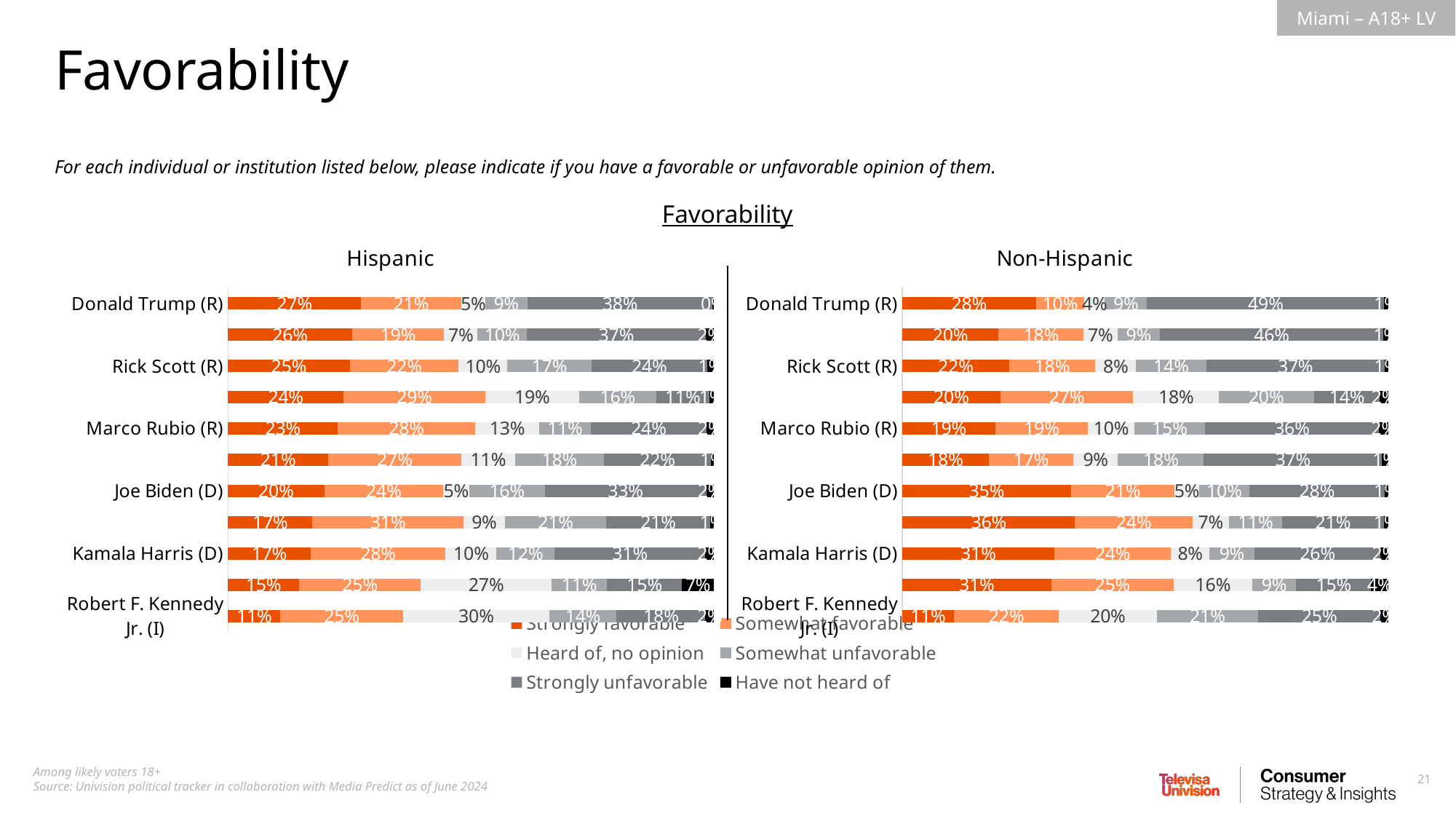
In the Hispanic chart, who has the higher Strongly favorable value, Donald Trump (R) or Joe Biden (D)? Donald Trump (R) In the Hispanic chart, what percentage of respondents are Strongly favorable toward Donald Trump (R)? 27% In the Hispanic chart, what is the 'Heard of, no opinion' value for Robert F. Kennedy Jr. (I)? 30% How many series does the legend list? 6 In the Hispanic chart, what is the Somewhat favorable value for Marco Rubio (R)? 28% In the Non-Hispanic chart, what is the difference between the Strongly unfavorable values for Donald Trump (R) and Joe Biden (D)? 21 percentage points What is the title shown above the two charts? Favorability In the Non-Hispanic chart, what is the Strongly unfavorable value for Rick Scott (R)? 37% In the Hispanic chart, which named individual has the highest Strongly favorable value? Donald Trump (R) In the Non-Hispanic chart, what percentage of respondents are Strongly unfavorable toward Donald Trump (R)? 49% What kind of chart is used to show the Hispanic favorability data? Stacked bar chart In the Non-Hispanic chart, what is the Strongly favorable value for Joe Biden (D)? 35%